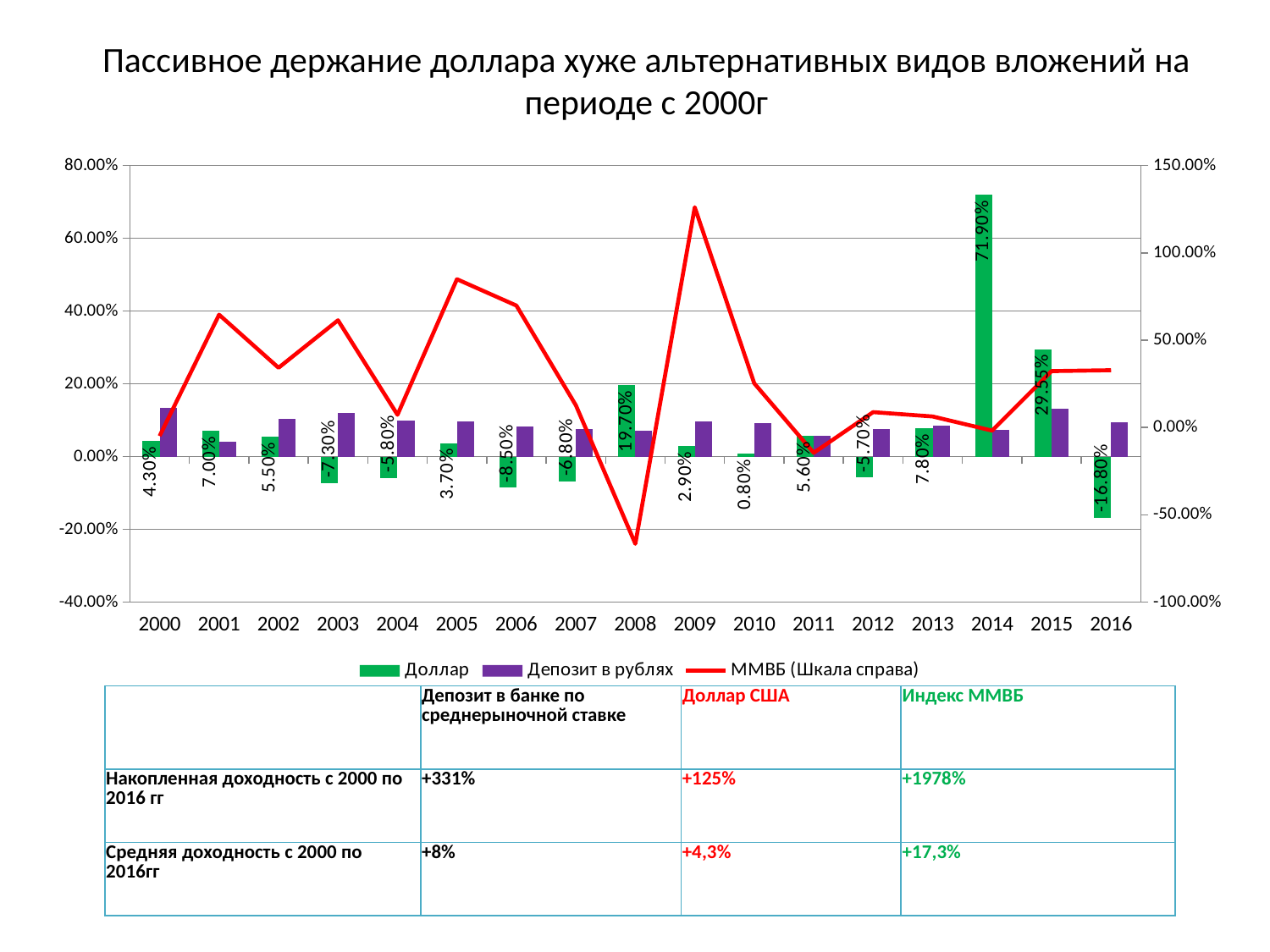
What is the value of the Доллар series for 2014? 71.90% Is the ММВБ value for 2009 greater or less than 100.00% on the right axis? greater What is the difference between the Доллар values for 2014 and 2015? 42.35% How many series does the chart legend list? 3 Which series in the chart is plotted against the right-hand axis? ММВБ (Шкала справа) What is the value of the Доллар series for 2016? -16.80% In which year is the Доллар series highest? 2014 In which year is the Доллар series lowest? 2016 What is the value of the Доллар series for 2008? 19.70% How many years are shown on the x axis of the chart? 17 Is the Депозит в рублях value for 2003 greater or less than 20.00%? less Which year has the larger Доллар value, 2001 or 2002? 2001